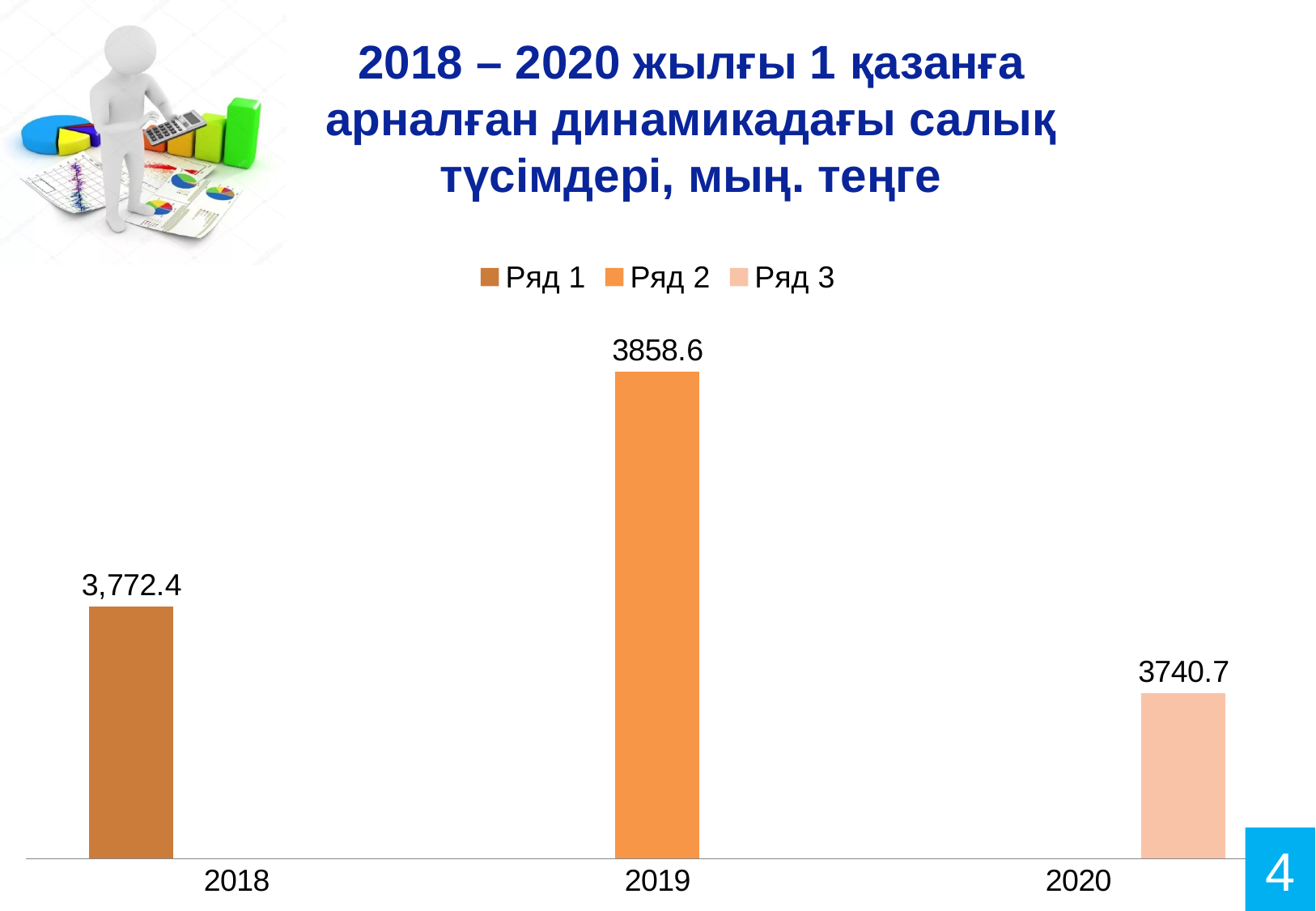
What is the value shown for 2020? 3740.7 What is the value shown for 2018? 3,772.4 Does the value rise or fall from 2019 to 2020? Fall What is the difference between the values for 2019 and 2018? 86.2 What is the difference between the values for 2018 and 2020? 31.7 Which is larger, the value for 2018 or the value for 2020? 2018 Which year has the highest value? 2019 Which year has the lowest value? 2020 What is the value shown for 2019? 3858.6 How many years are shown on the x axis? 3 How many series does the legend list? 3 What kind of chart is shown on the slide? Bar chart